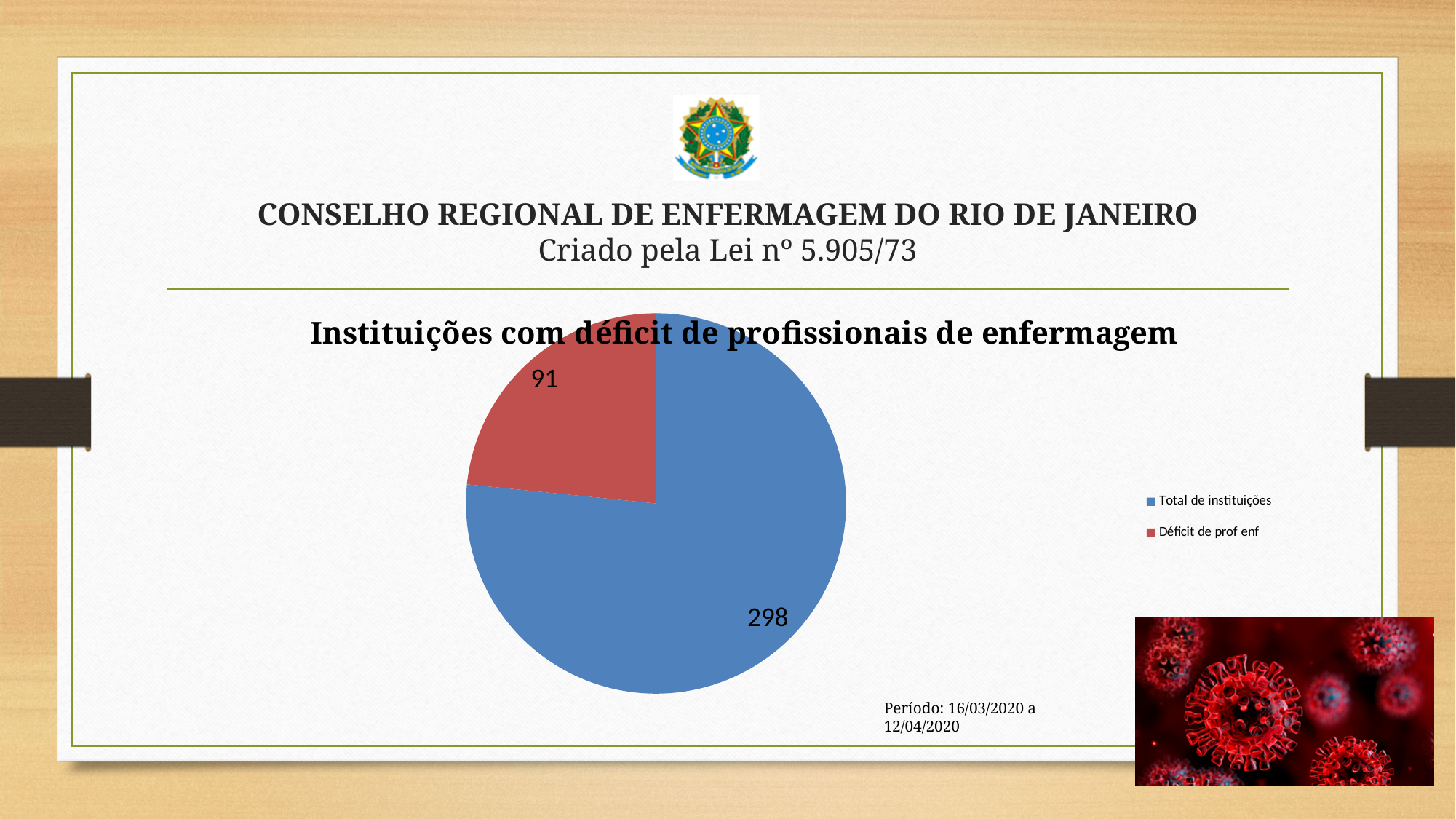
What is the title of the pie chart? Instituições com déficit de profissionais de enfermagem What colour is the slice for "Déficit de prof enf" in the pie chart? red What is the difference between the values for "Total de instituições" and "Déficit de prof enf"? 207 Which slice of the pie chart is the smallest? Déficit de prof enf What is the value for "Total de instituições" in the pie chart? 298 How many slices does the pie chart have? 2 What type of chart is shown on the slide? pie chart What is the sum of the two values shown in the pie chart? 389 Which is larger, the value for "Total de instituições" or the value for "Déficit de prof enf"? Total de instituições Which slice of the pie chart is the largest? Total de instituições What is the value for "Déficit de prof enf" in the pie chart? 91 How many entries does the legend of the pie chart list? 2